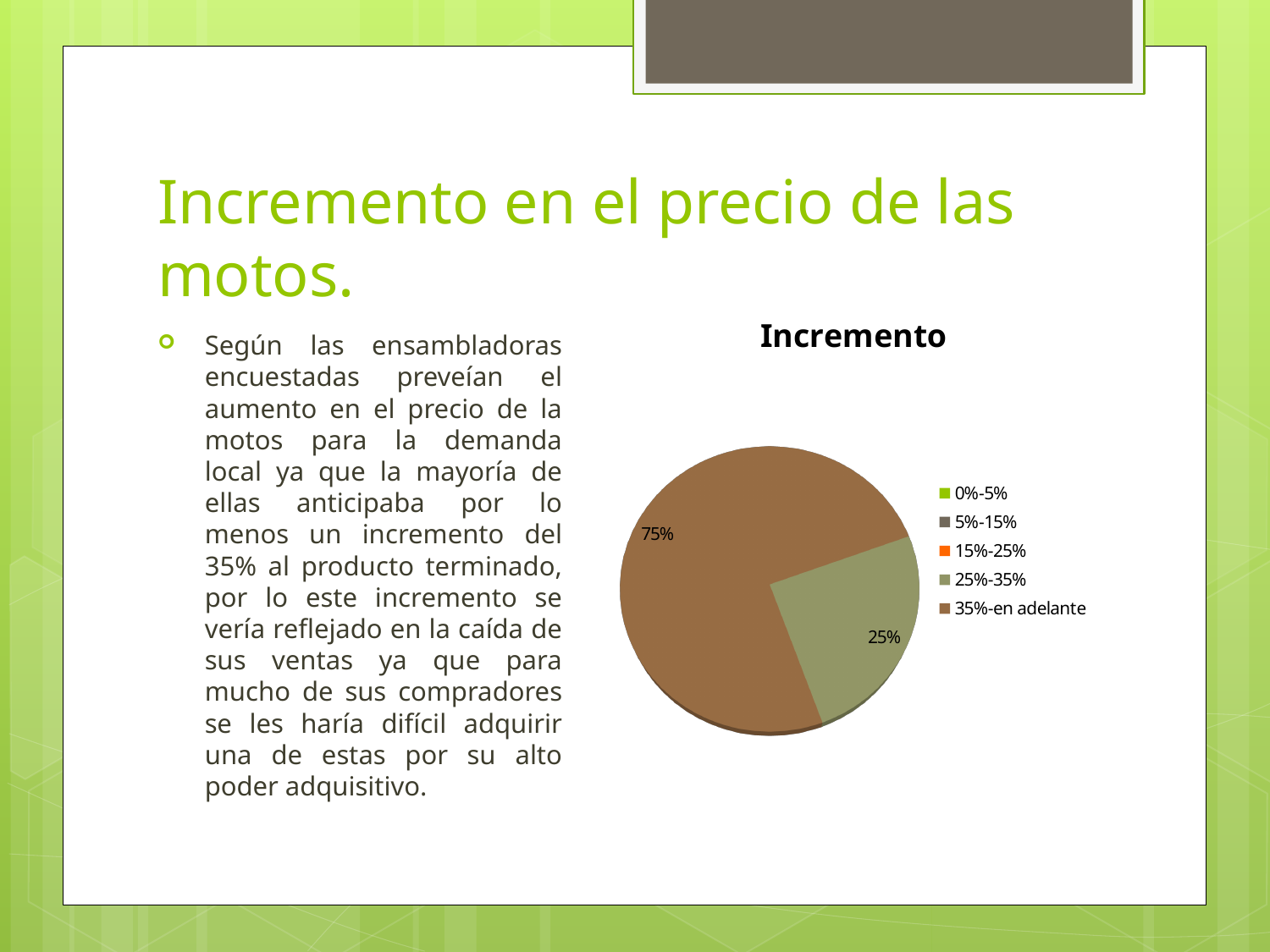
What kind of chart is shown on the slide? pie chart How many entries does the chart's legend list? 5 What share of the pie does the '25%-35%' slice represent? 25% Which of the two visible slices is larger, '25%-35%' or '35%-en adelante'? 35%-en adelante What is the difference between the '35%-en adelante' slice and the '25%-35%' slice? 50% What is the first entry listed in the legend? 0%-5% What share of the pie does the '35%-en adelante' slice represent? 75% Which category has the largest slice of the pie? 35%-en adelante How many slices are visible in the pie? 2 What is the total of the two labelled slices in the pie? 100% What is the title of the chart? Incremento